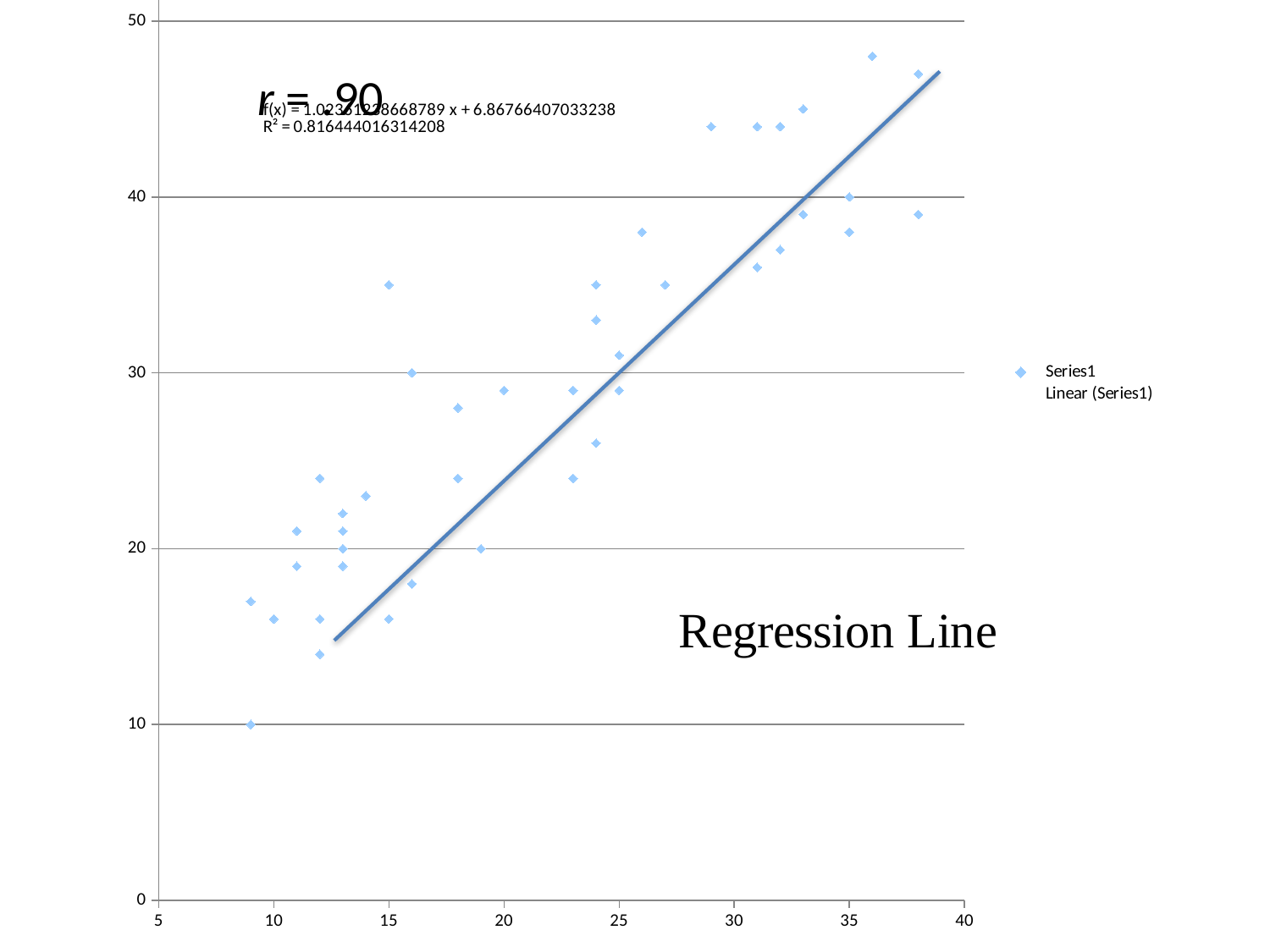
What is the maximum value shown on the y axis? 50 Does the regression line slope upward or downward from left to right? upward What is the title text shown on the chart? Regression Line Is the y value of the highest plotted point greater or less than 40? greater How many entries does the legend list? 2 Do the plotted values generally rise or fall as x increases? rise Is the y value of the plotted point at x = 9 with the lowest y greater or less than 20? less What kind of chart is shown on the slide? scatter chart What is the R² value printed on the chart? 0.816444016314208 Is the y value of the lowest plotted point greater or less than 20? less